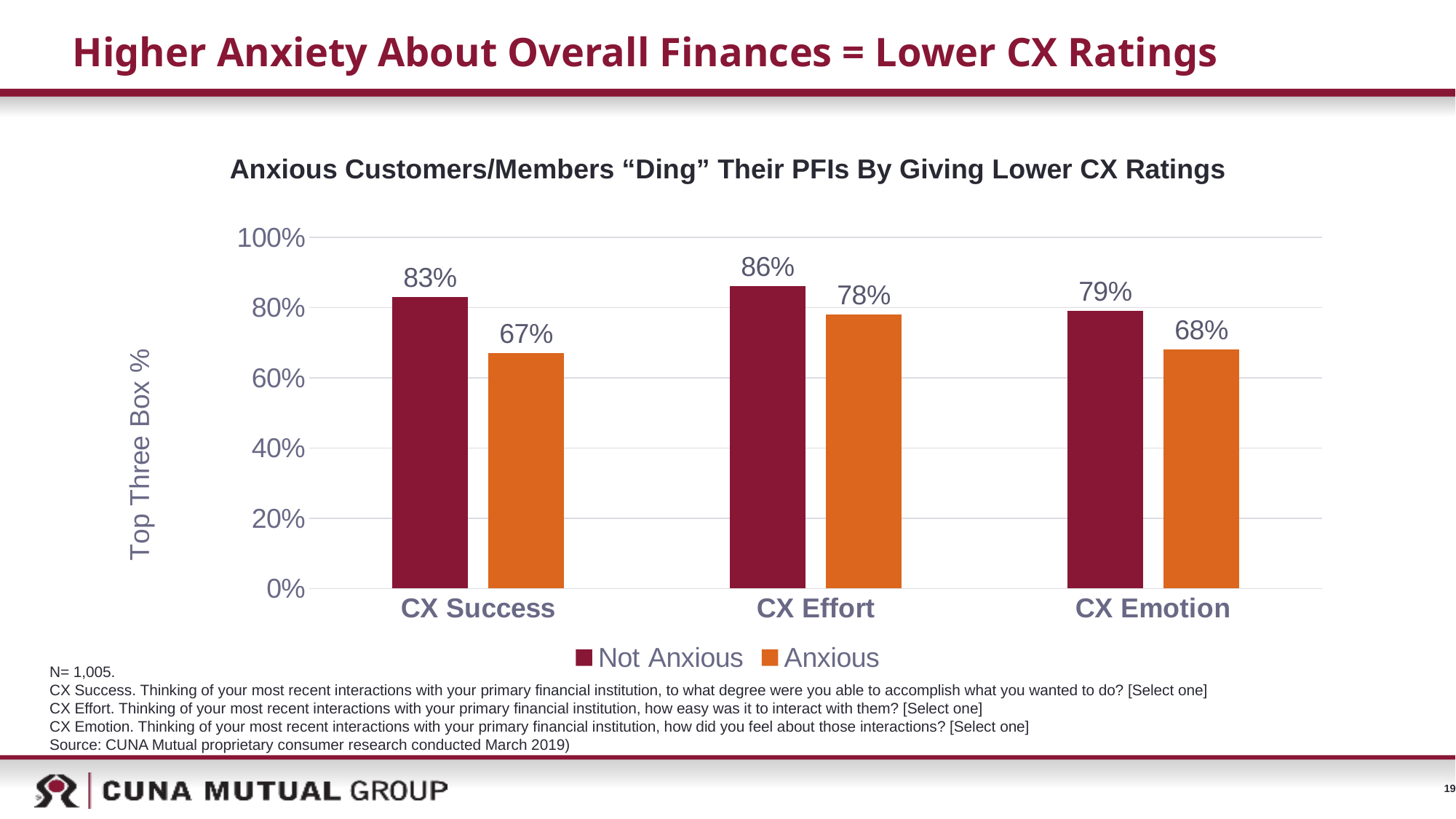
What is the Not Anxious value for CX Success? 83% What is the difference between the Not Anxious and Anxious values for CX Success? 16% Which category has the lowest Anxious value? CX Success What kind of chart is shown on the slide? bar chart How many series does the legend list? 2 What is the difference between the Not Anxious and Anxious values for CX Emotion? 11% Which is larger for CX Effort, the Not Anxious value or the Anxious value? Not Anxious Which category has the highest Not Anxious value? CX Effort What is the Anxious value for CX Effort? 78% Is the Anxious value for CX Success greater or less than 80%? less How many categories are shown on the x axis? 3 What is the Anxious value for CX Emotion? 68%